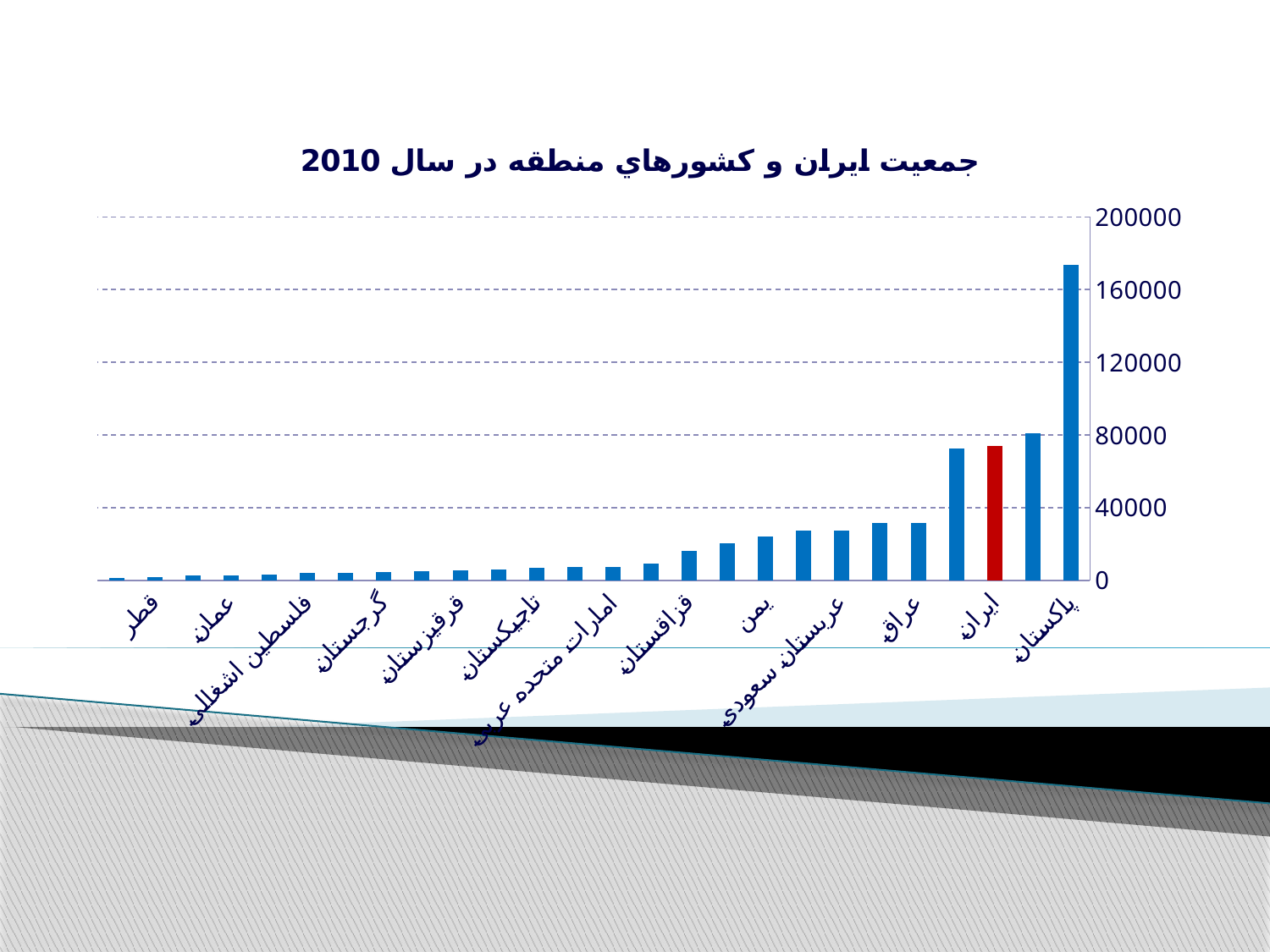
What kind of chart is shown on the slide? bar chart Is the value for ایران greater or less than 40000? greater Is the value for ایران greater or less than 80000? less Which country's bar is coloured red instead of blue? ایران Do the bar values rise or fall moving from left to right along the x axis? rise Which country has the highest population in the chart? پاکستان Is the value for پاکستان greater or less than 160000? greater Which has a larger value, یمن or قزاقستان? یمن What is the title of the chart? جمعيت ايران و کشورهاي منطقه در سال 2010 Which has a larger value, ایران or عراق? ایران